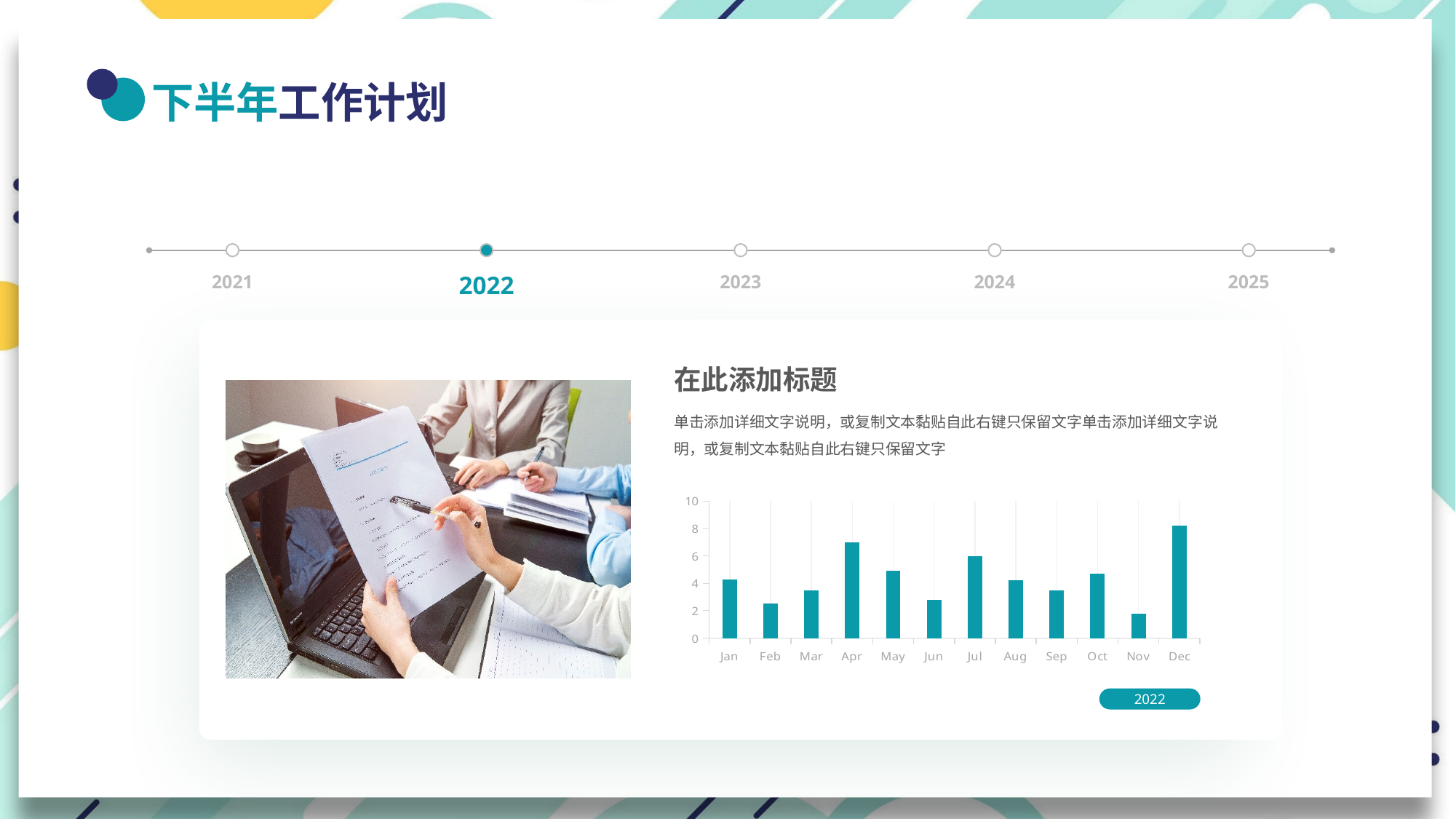
Is the value for Feb greater or less than 4? less Which month has the highest bar in the chart? Dec Which month has the lowest bar in the chart? Nov Is the value for Nov greater or less than 2? less How many categories (months) are plotted on the x axis of the chart? 12 Is the value for Jul greater or less than 4? greater What kind of chart is shown on the slide? bar chart Which is larger, the value for Feb or the value for Nov? Feb Which is larger, the value for Apr or the value for Jul? Apr